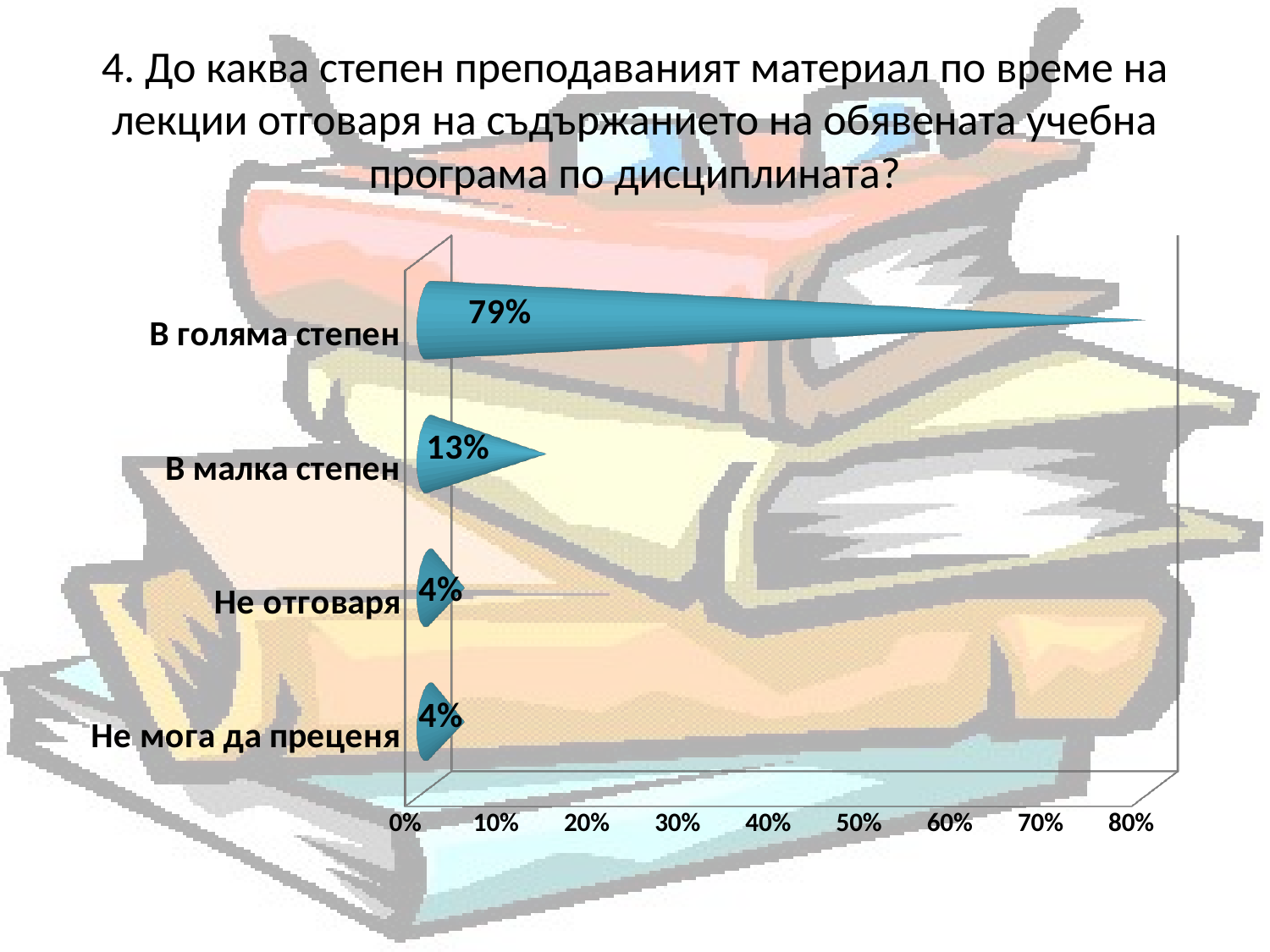
Which is larger, the value for "В малка степен" or the value for "Не отговаря"? В малка степен How many categories are shown in the chart? 4 What is the value for "Не отговаря"? 4% What is the difference between the values for "В голяма степен" and "В малка степен"? 66% What kind of chart is shown on the slide? bar chart Is the value for "В голяма степен" greater or less than 70%? greater What is the value for "В малка степен"? 13% What is the value for "Не мога да преценя"? 4% What is the maximum value shown on the horizontal axis? 80% What is the value for "В голяма степен"? 79% Is the value for "В малка степен" greater or less than 20%? less Which category has the highest value? В голяма степен